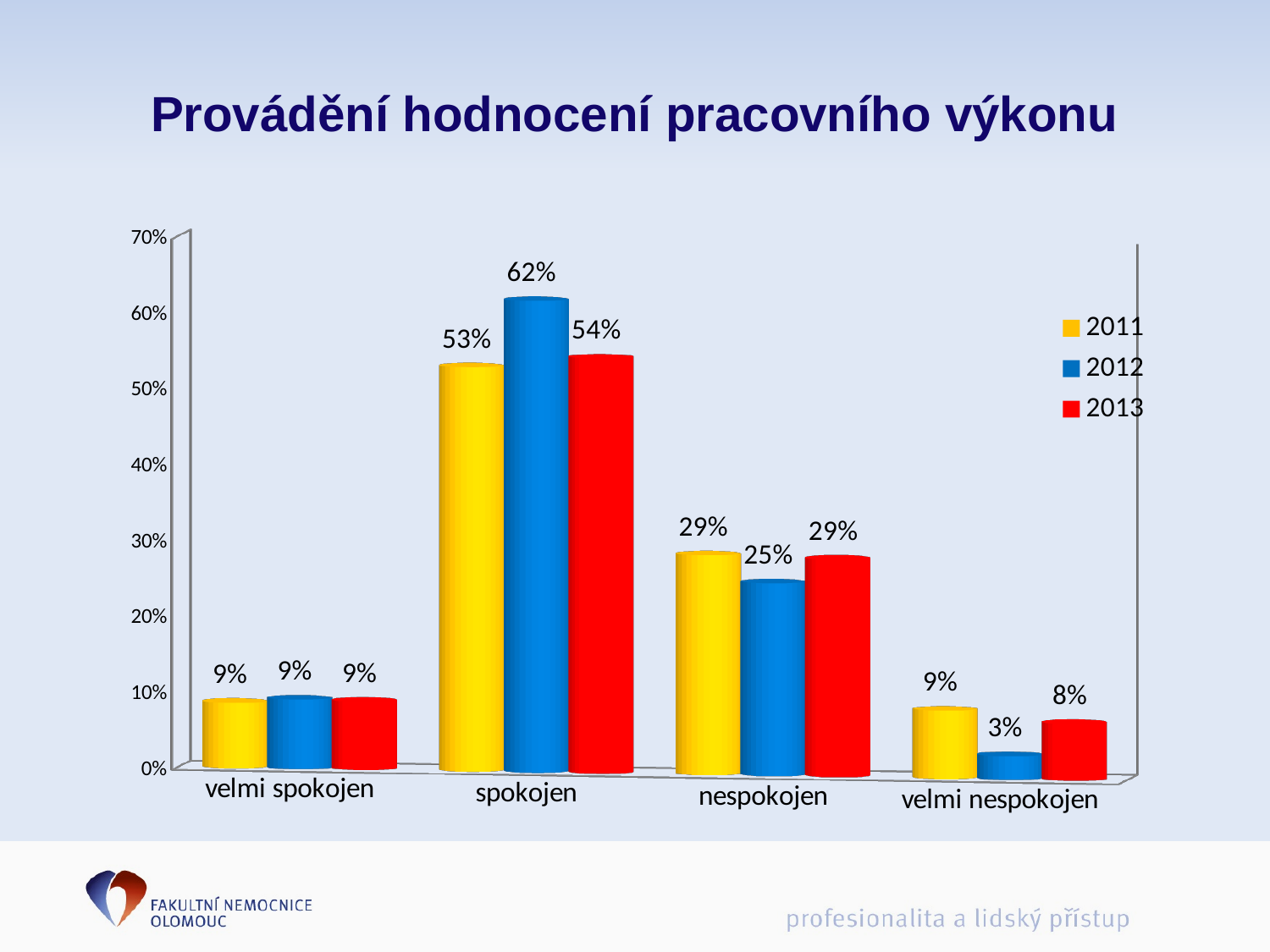
Which category has the lowest value for 2012? velmi nespokojen Which is larger for 'nespokojen': the 2011 value or the 2012 value? 2011 What is the value for 'velmi nespokojen' in 2012? 3% What is the difference between the 2012 and 2011 values for 'spokojen'? 9% What is the value for 'spokojen' in 2011? 53% What is the value for 'nespokojen' in 2013? 29% What kind of chart is shown on the slide? bar chart Which category has the highest value for 2013? spokojen What is the title of the chart? Provádění hodnocení pracovního výkonu What is the value for 'spokojen' in 2012? 62% How many categories are shown on the x axis? 4 How many series does the legend list? 3